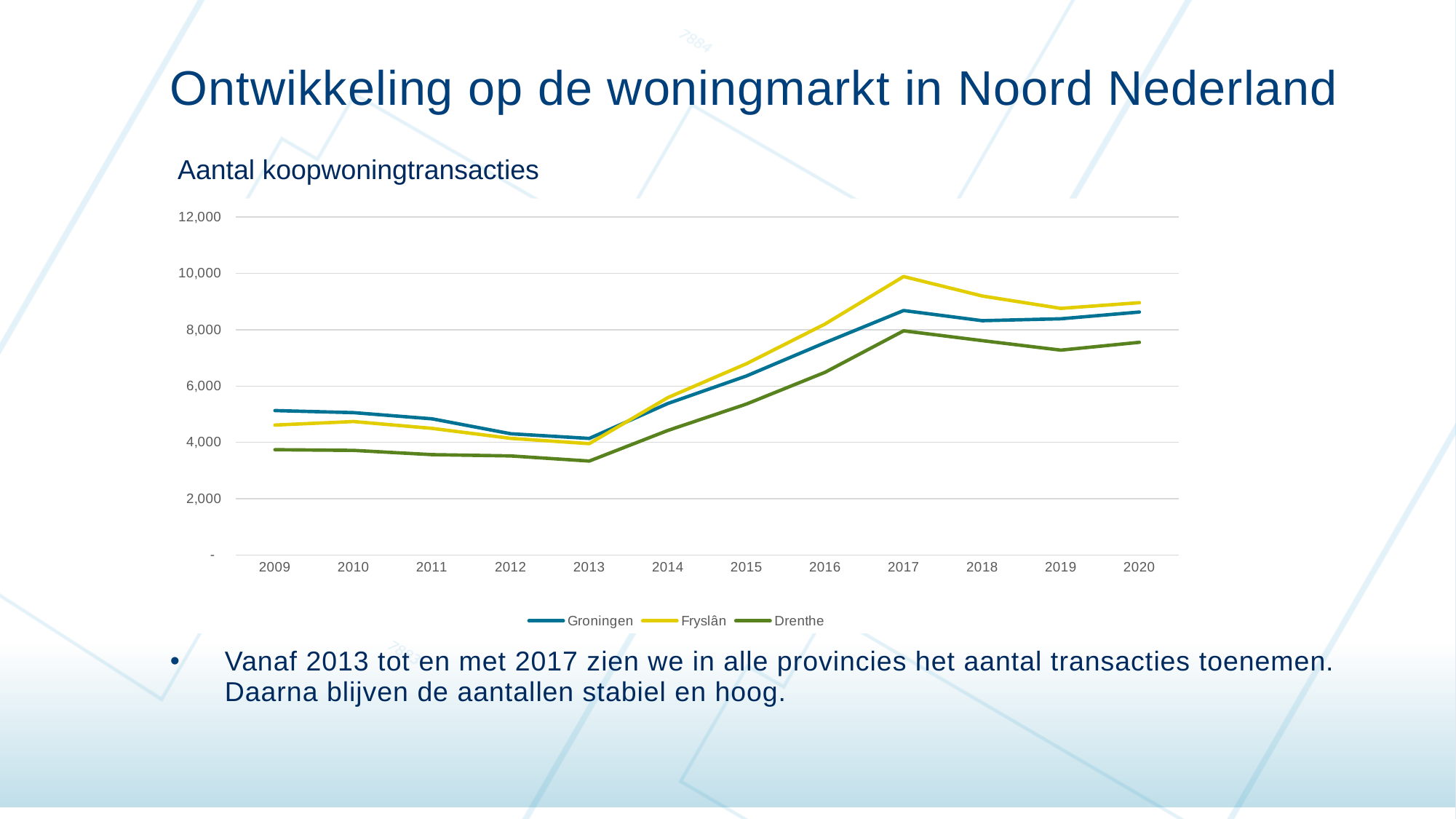
Does the value for Drenthe rise or fall from 2009 to 2013? Fall Which province has the lowest number of transactions in 2013? Drenthe Is the value for Fryslân in 2017 greater or less than 8,000? greater In which year does Drenthe reach its lowest value? 2013 Which is larger in 2009, the value for Groningen or the value for Fryslân? Groningen What kind of chart is shown on the slide? Line chart How many series does the legend list? 3 How many years are plotted along the x axis? 12 Which province has the highest number of transactions in 2017? Fryslân In which year does Fryslân reach its highest value? 2017 Is the value for Drenthe in 2020 greater or less than 8,000? less Is the value for Drenthe in 2013 greater or less than 4,000? less